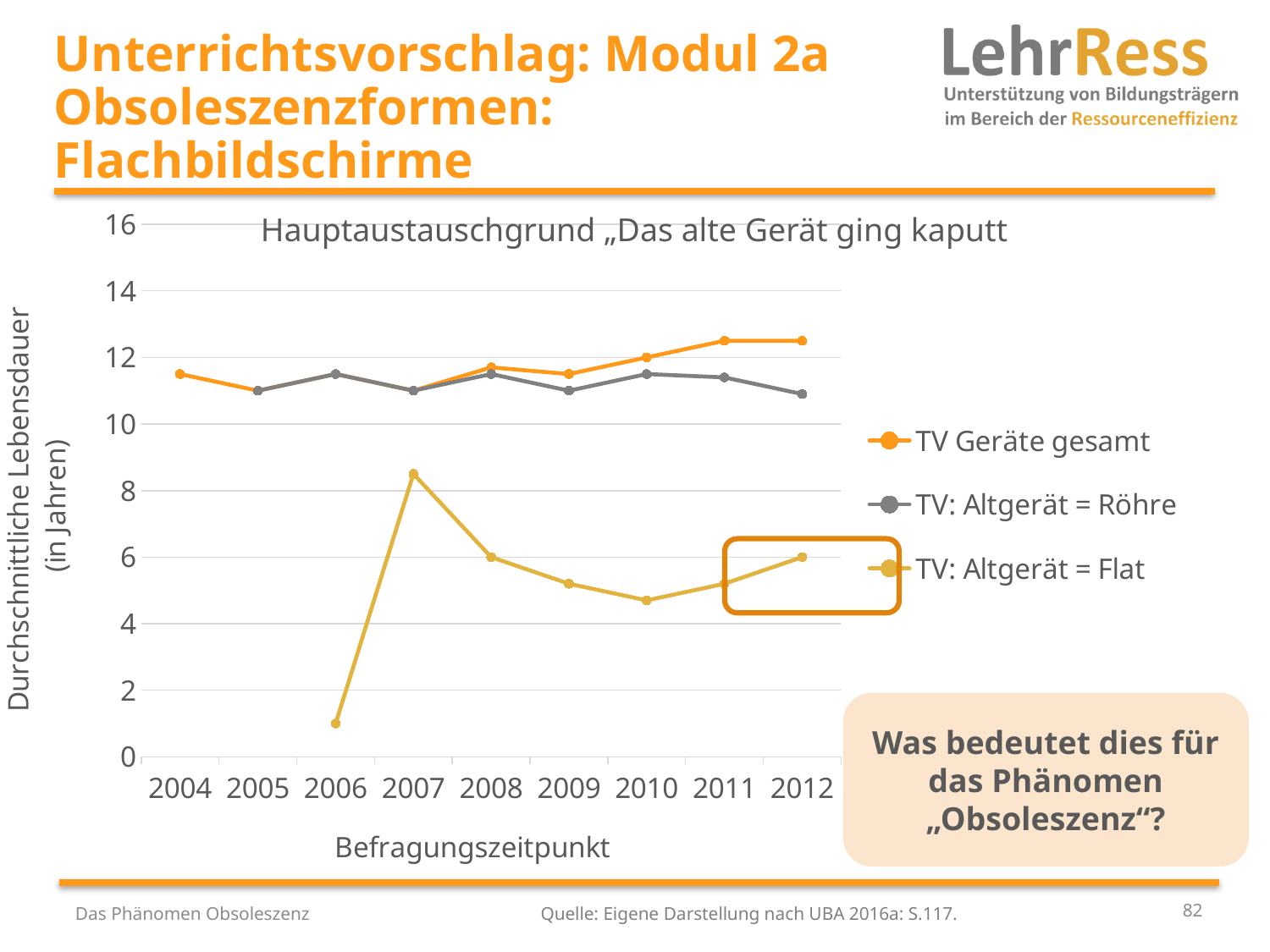
In which year does the series "TV: Altgerät = Flat" have its lowest value? 2006 In which year does the series "TV: Altgerät = Flat" reach its highest value? 2007 What kind of chart is shown on the slide? line chart Is the value for "TV: Altgerät = Flat" in 2007 greater or less than 8? greater Is the value for "TV: Altgerät = Röhre" in 2012 greater or less than 12? less How many series does the legend list? 3 Does the series "TV Geräte gesamt" rise or fall from 2008 to 2012? rise Is the value for "TV: Altgerät = Flat" in 2006 greater or less than 2? less How many years are shown on the x axis? 9 What is the title of the y axis? Durchschnittliche Lebensdauer (in Jahren) In 2012, which series has the larger value: "TV Geräte gesamt" or "TV: Altgerät = Röhre"? TV Geräte gesamt